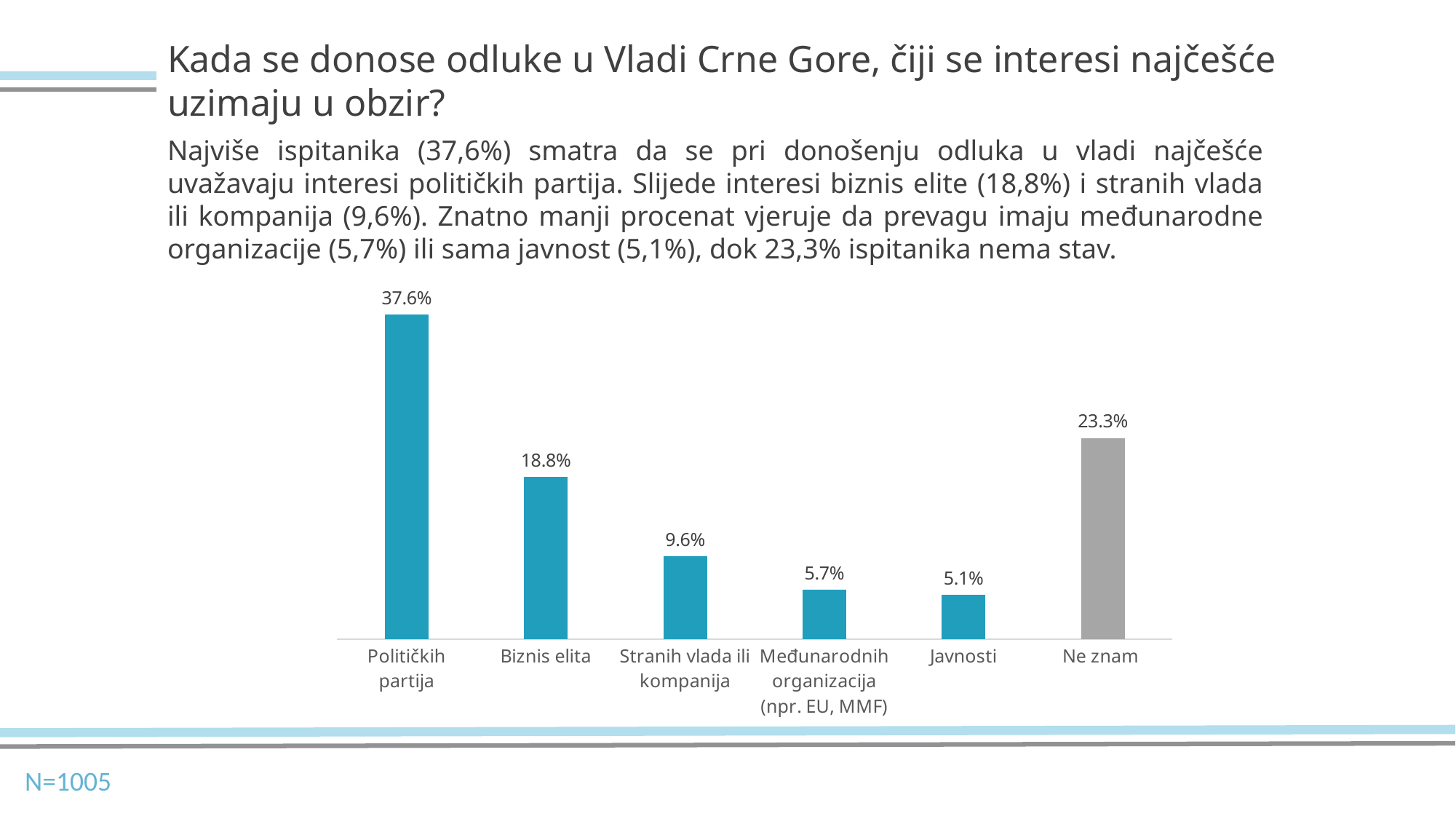
What is the value for Biznis elita? 18.8% What is the difference between the values for Međunarodnih organizacija (npr. EU, MMF) and Javnosti? 0.6% What is the value for Ne znam? 23.3% What is the value for Političkih partija? 37.6% How many categories are shown in the chart? 6 What is the value for Stranih vlada ili kompanija? 9.6% Which is larger, the value for Ne znam or the value for Biznis elita? Ne znam Which bar is coloured grey rather than blue? Ne znam What is the difference between the values for Političkih partija and Biznis elita? 18.8% Which category has the highest value? Političkih partija Which category has the lowest value? Javnosti What kind of chart is shown on the slide? Bar chart